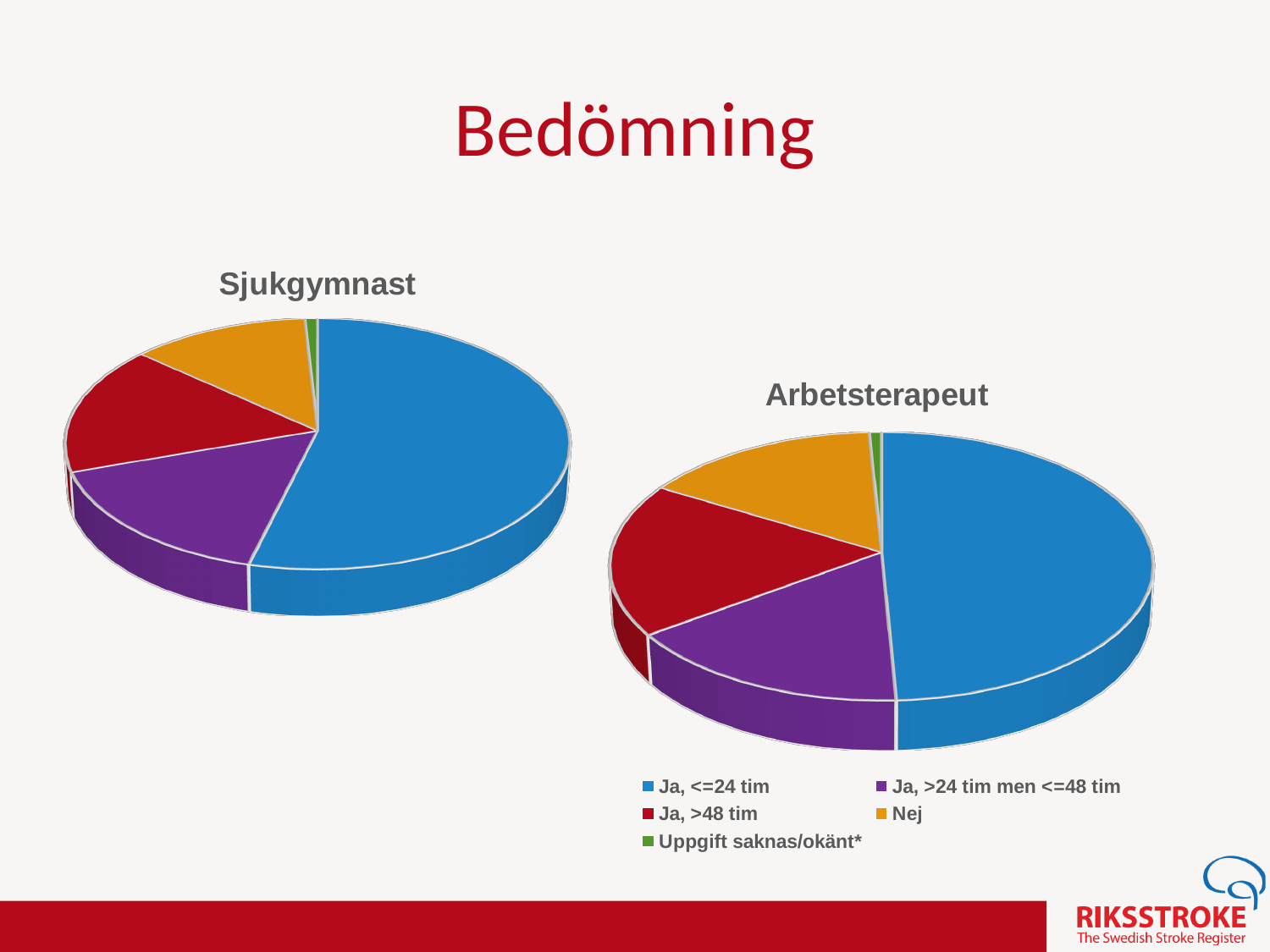
In the Sjukgymnast chart, which category has the smallest slice? Uppgift saknas/okänt* In the Arbetsterapeut chart, which category has the smallest slice? Uppgift saknas/okänt* How many slices does the Arbetsterapeut pie chart have? 5 How many categories does the legend list for the pie charts? 5 What kind of chart is the Arbetsterapeut chart? pie chart In the Arbetsterapeut chart, which category has the largest slice? Ja, <=24 tim Which colour represents the category Nej in the pie charts? orange In the Sjukgymnast chart, which slice is larger: Ja, <=24 tim or Nej? Ja, <=24 tim In the Sjukgymnast chart, which category has the largest slice? Ja, <=24 tim What kind of chart is the Sjukgymnast chart? pie chart In the Arbetsterapeut chart, which slice is larger: Ja, >48 tim or Uppgift saknas/okänt*? Ja, >48 tim What is the title of the slide containing the two pie charts? Bedömning